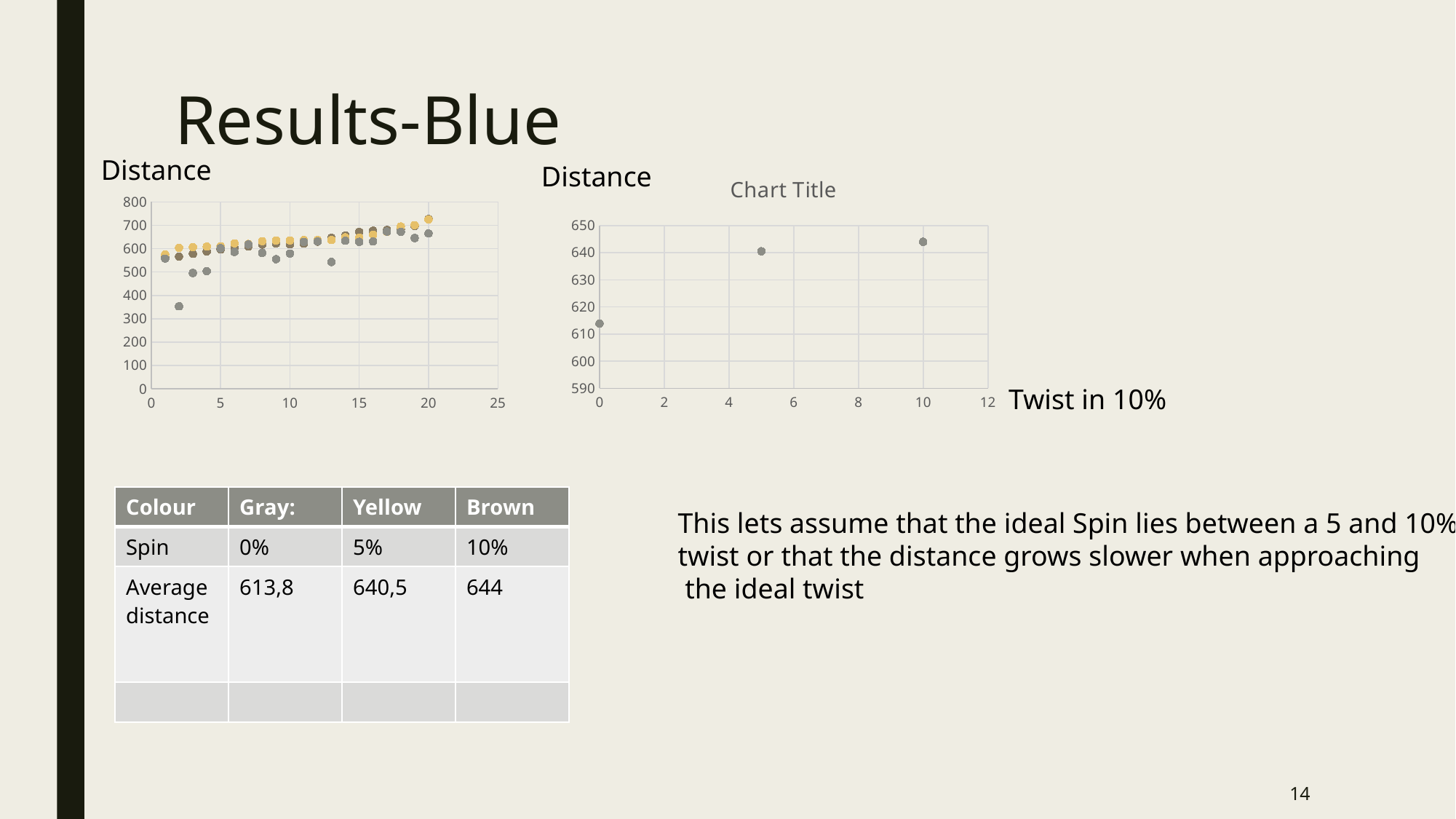
On the right-hand chart titled "Chart Title", at which x value is the plotted point lowest? 0 How many data points are plotted on the right-hand chart titled "Chart Title"? 3 On the right-hand chart titled "Chart Title", do the values rise or fall as x increases? rise On the right-hand chart titled "Chart Title", is the value at x = 0 greater or less than 620? less On the right-hand chart titled "Chart Title", is the value at x = 10 greater or less than 640? greater What kind of chart is the left-hand chart labelled "Distance"? scatter chart On the right-hand chart titled "Chart Title", is the value at x = 5 greater or less than 630? greater What is the x-axis label written next to the right-hand chart titled "Chart Title"? Twist in 10% What is the highest value shown on the y axis of the left-hand chart labelled "Distance"? 800 On the right-hand chart titled "Chart Title", which point is higher: the one at x = 0 or the one at x = 5? x = 5 What kind of chart is the right-hand chart titled "Chart Title"? scatter chart